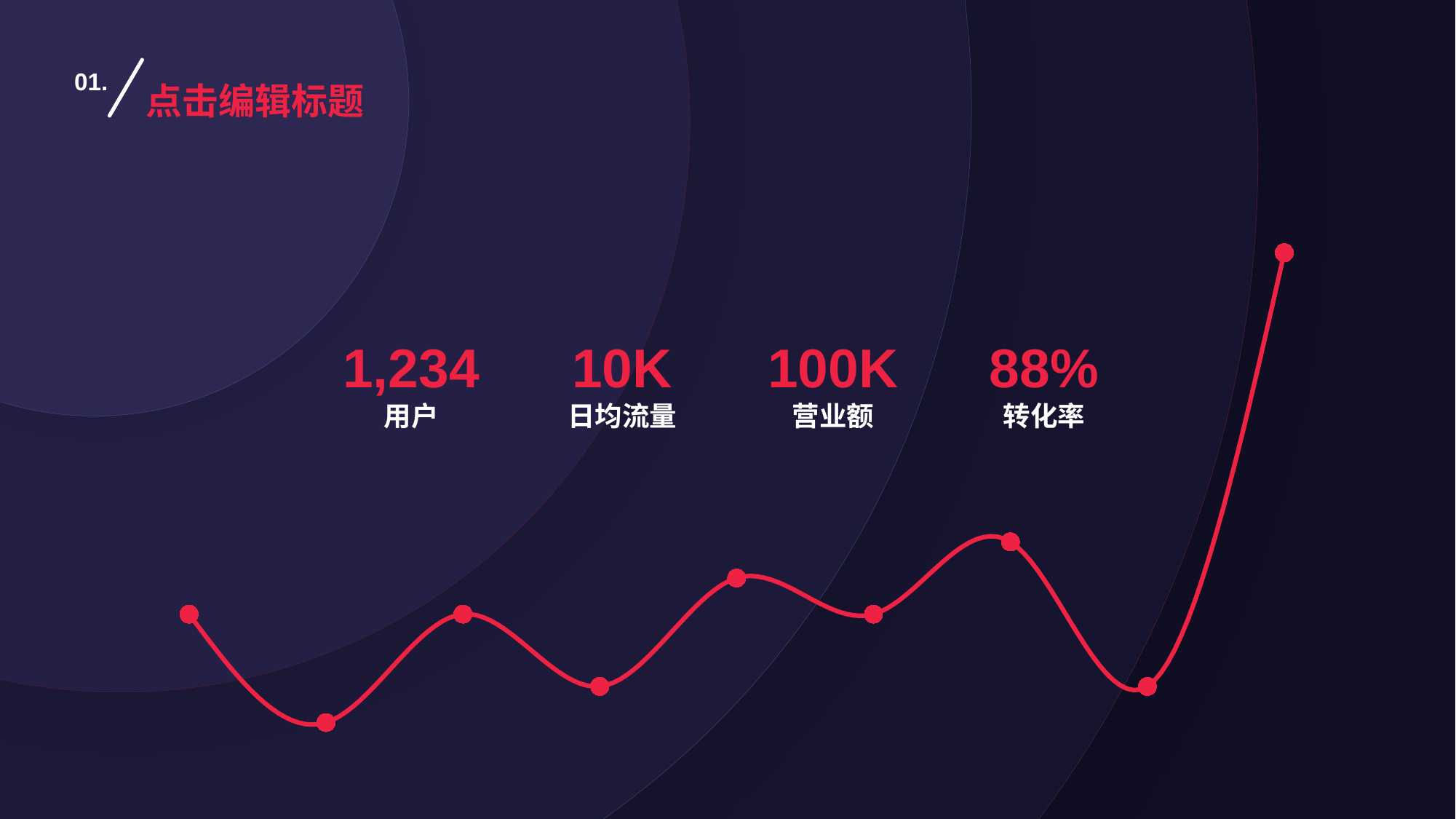
Which data point on the line chart is the lowest? the second point from the left Which is higher on the line chart, the first point or the last point? the last point Does the line chart show a legend? no What kind of chart is shown on the slide? line chart What colour is the line in the chart? red How many data points are marked on the line chart? 9 Which is higher on the line chart, the third point or the seventh point? the seventh point Overall, does the line rise or fall from the leftmost point to the rightmost point? rises Which data point on the line chart is the highest? the last (rightmost) point Which is higher on the line chart, the fifth point or the sixth point? the fifth point